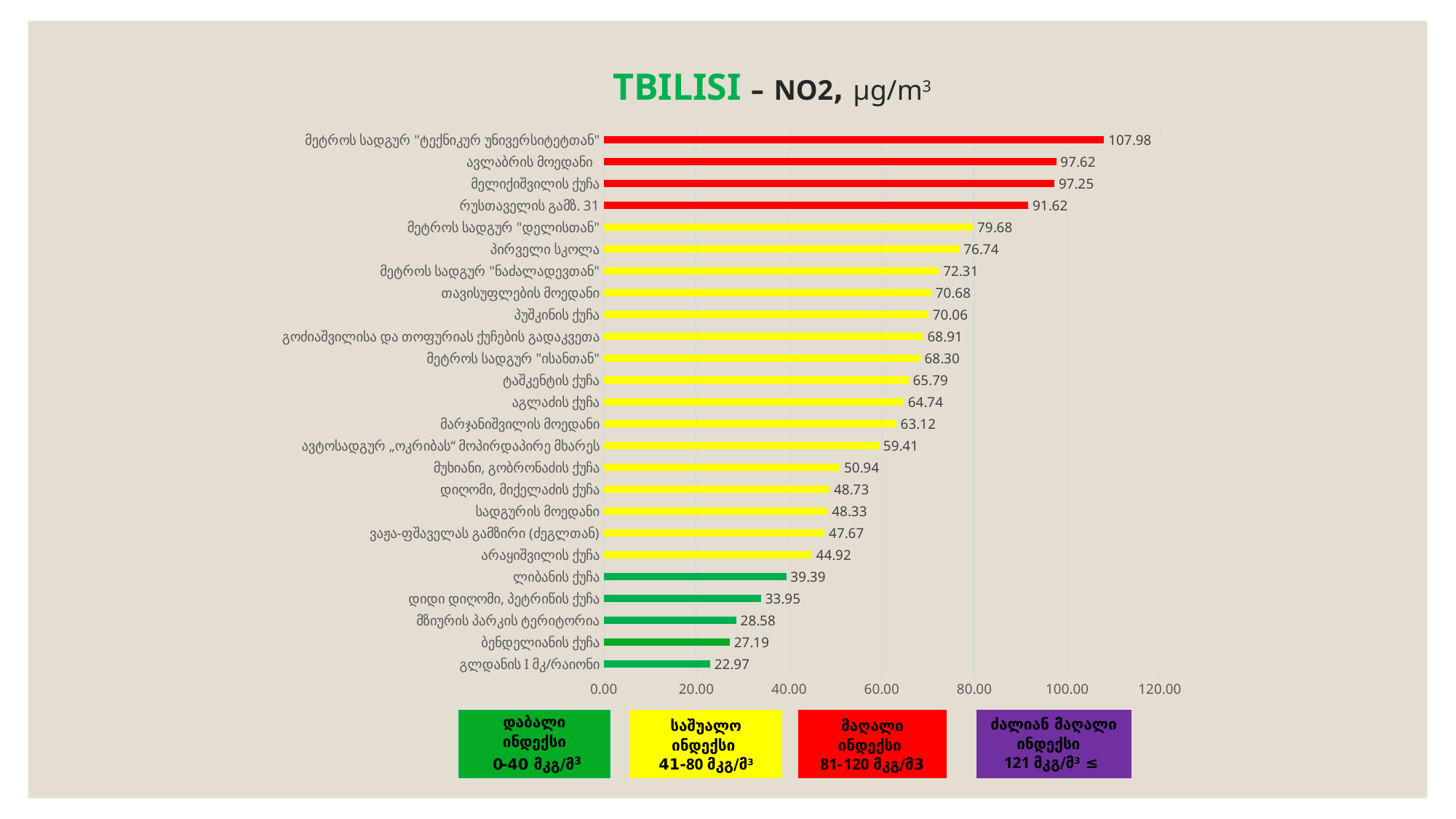
What colour are the bars for the four highest NO2 values? red What is the NO2 value for პუშკინის ქუჩა? 70.06 Which location has the highest NO2 value? მეტროს სადგურ "ტექნიკურ უნივერსიტეტთან" How many locations are shown in the chart? 25 What is the difference between the NO2 values for ბენდელიანის ქუჩა and გლდანის I მკ/რაიონი? 4.22 Which has a higher NO2 value, თავისუფლების მოედანი or მარჯანიშვილის მოედანი? თავისუფლების მოედანი What type of chart is shown on the slide? bar chart What is the difference between the NO2 values for მეტროს სადგურ "ტექნიკურ უნივერსიტეტთან" and რუსთაველის გამზ. 31? 16.36 What is the NO2 value for ავლაბრის მოედანი? 97.62 Which location has the lowest NO2 value? გლდანის I მკ/რაიონი Is the NO2 value for პირველი სკოლა greater or less than 80.00? less What is the NO2 value for ლიბანის ქუჩა? 39.39